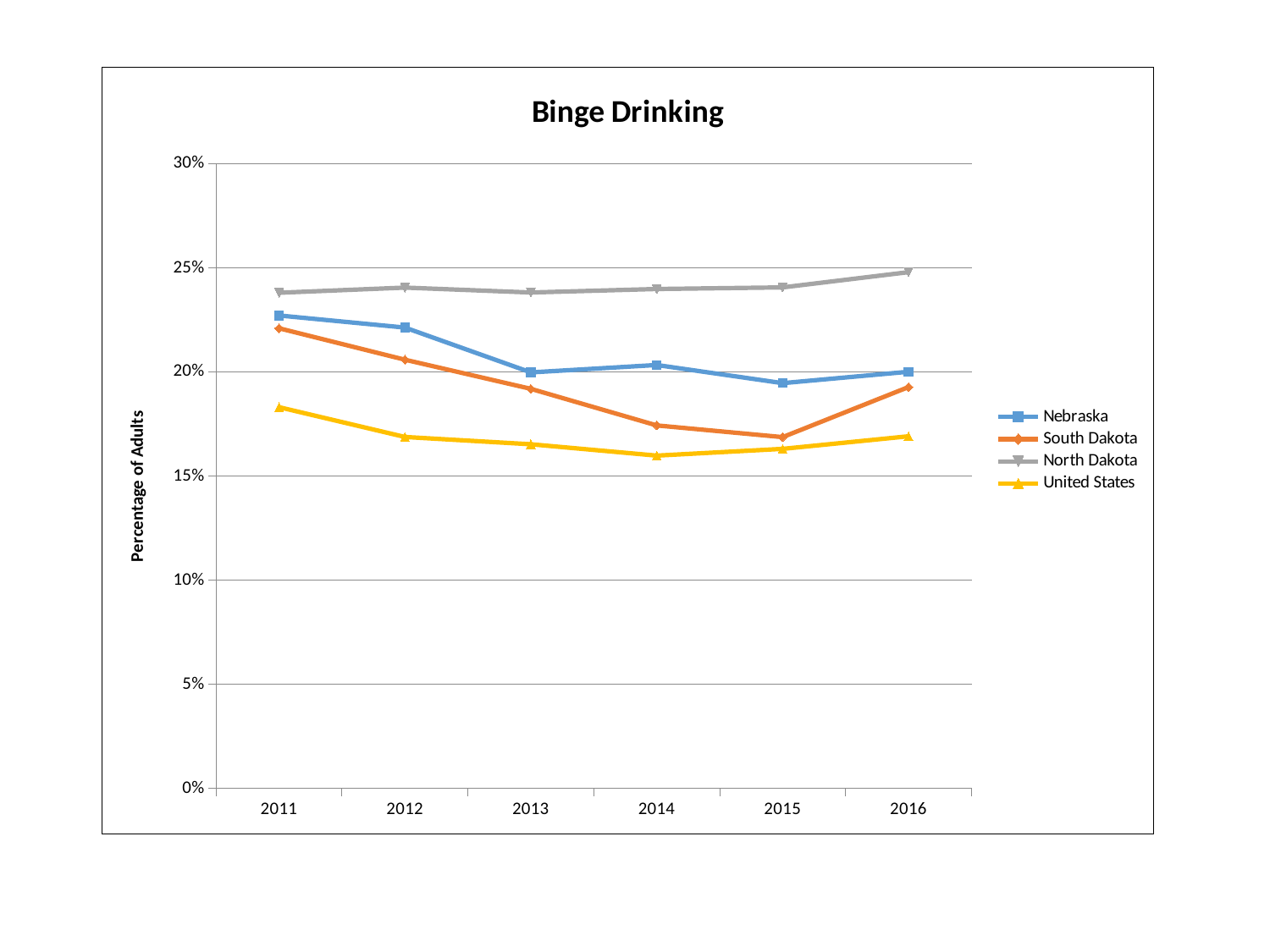
Which series has the lowest value in 2014? United States In 2014, which is larger: the value for Nebraska or the value for South Dakota? Nebraska Is the value for South Dakota in 2015 greater or less than 15%? greater What is the label on the vertical axis? Percentage of Adults Is the value for North Dakota in 2011 greater or less than 25%? less How many series does the legend list? 4 How many years are shown on the x axis? 6 Does the United States line rise or fall from 2011 to 2014? fall Is the value for United States in 2014 greater or less than 20%? less Which series has the highest value in 2016? North Dakota What kind of chart is shown on the slide? line chart What is the title of the chart? Binge Drinking